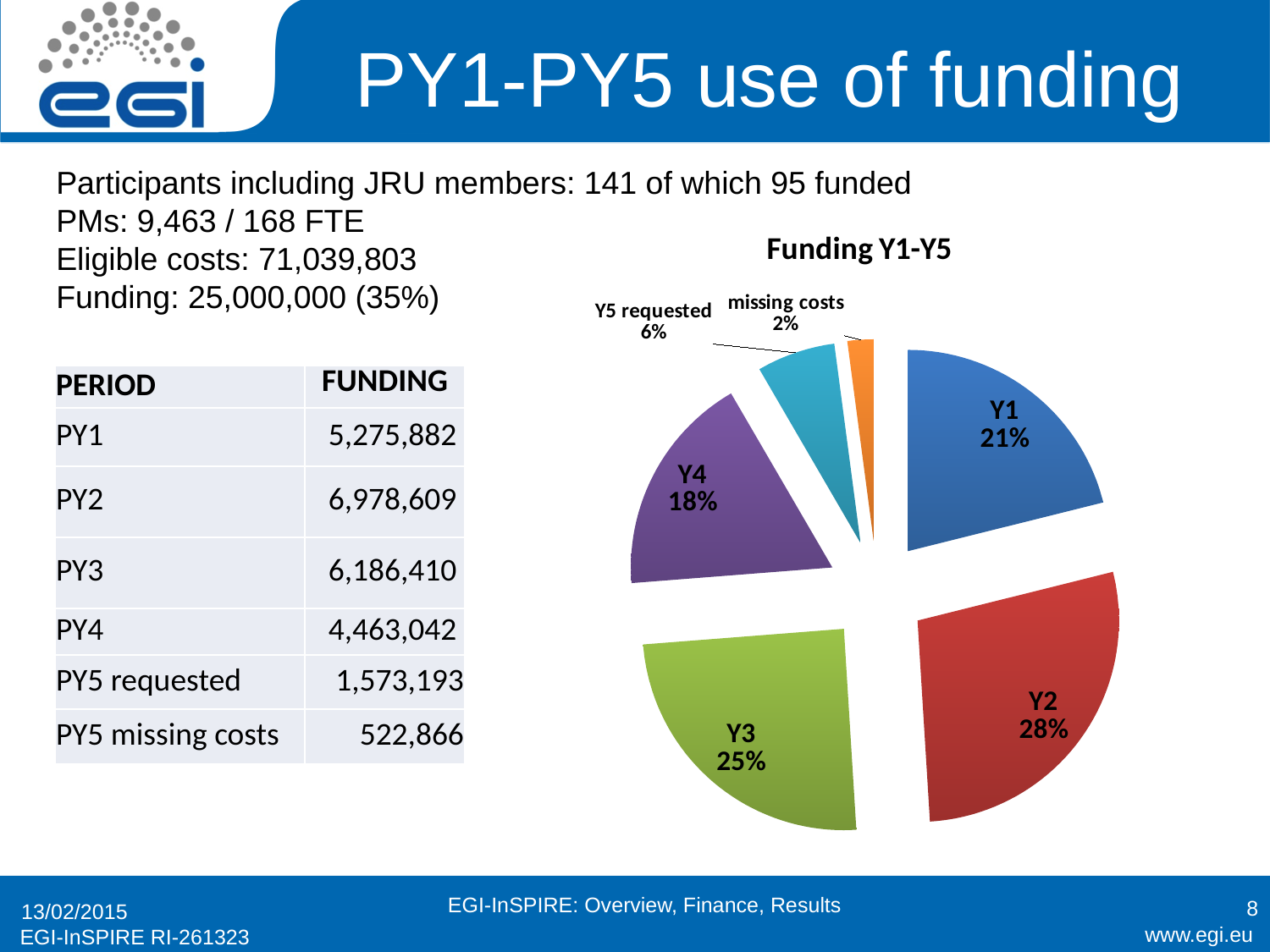
What is the title of the chart? Funding Y1-Y5 What is the difference in percentage points between the Y3 and Y1 slices? 4% Which slice of the pie is the largest? Y2 Which slice is larger, Y1 or Y4? Y1 What colour is the Y3 slice of the pie? green What share of the pie does the 'missing costs' slice represent? 2% What share of the pie does Y2 represent? 28% What share of the pie does 'Y5 requested' represent? 6% What type of chart is shown on the slide? pie chart How many slices does the pie chart have? 6 Which slice of the pie is the smallest? missing costs